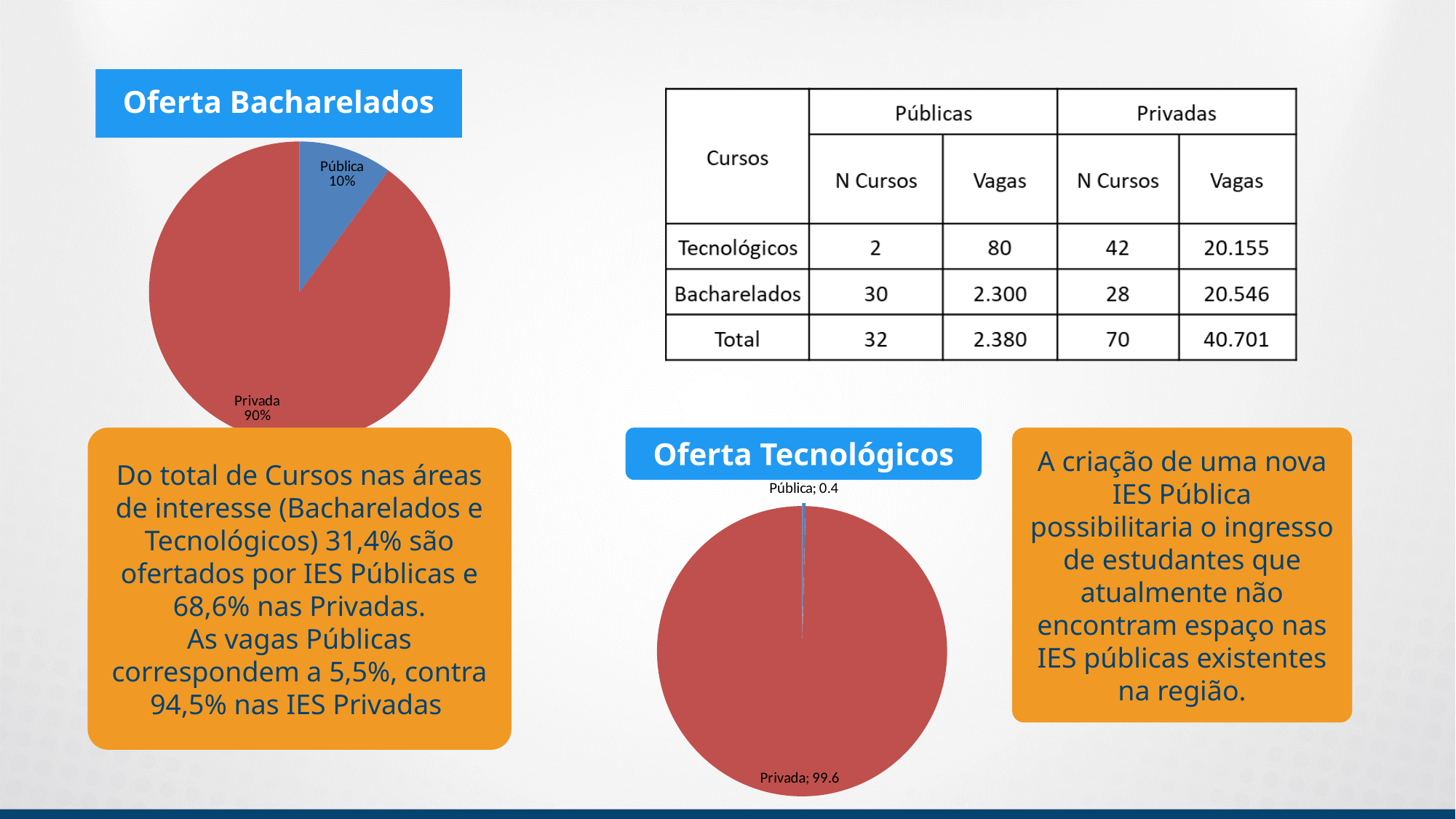
In the 'Oferta Tecnológicos' chart, what is the difference between the Privada and Pública values? 99.2 In the 'Oferta Bacharelados' chart, what colour is the Pública slice? Blue In the 'Oferta Bacharelados' chart, which slice is the largest? Privada In the 'Oferta Tecnológicos' chart, what value is shown for Pública? 0.4 In the 'Oferta Bacharelados' chart, what is the difference between the Privada and Pública shares? 80% In the 'Oferta Tecnológicos' chart, what value is shown for Privada? 99.6 In the 'Oferta Bacharelados' chart, what share does the Privada slice have? 90% What kind of chart is 'Oferta Bacharelados'? Pie chart In the 'Oferta Tecnológicos' chart, which slice is the smallest? Pública What kind of chart is 'Oferta Tecnológicos'? Pie chart How many slices does the 'Oferta Tecnológicos' pie chart have? 2 In the 'Oferta Bacharelados' chart, what share does the Pública slice have? 10%